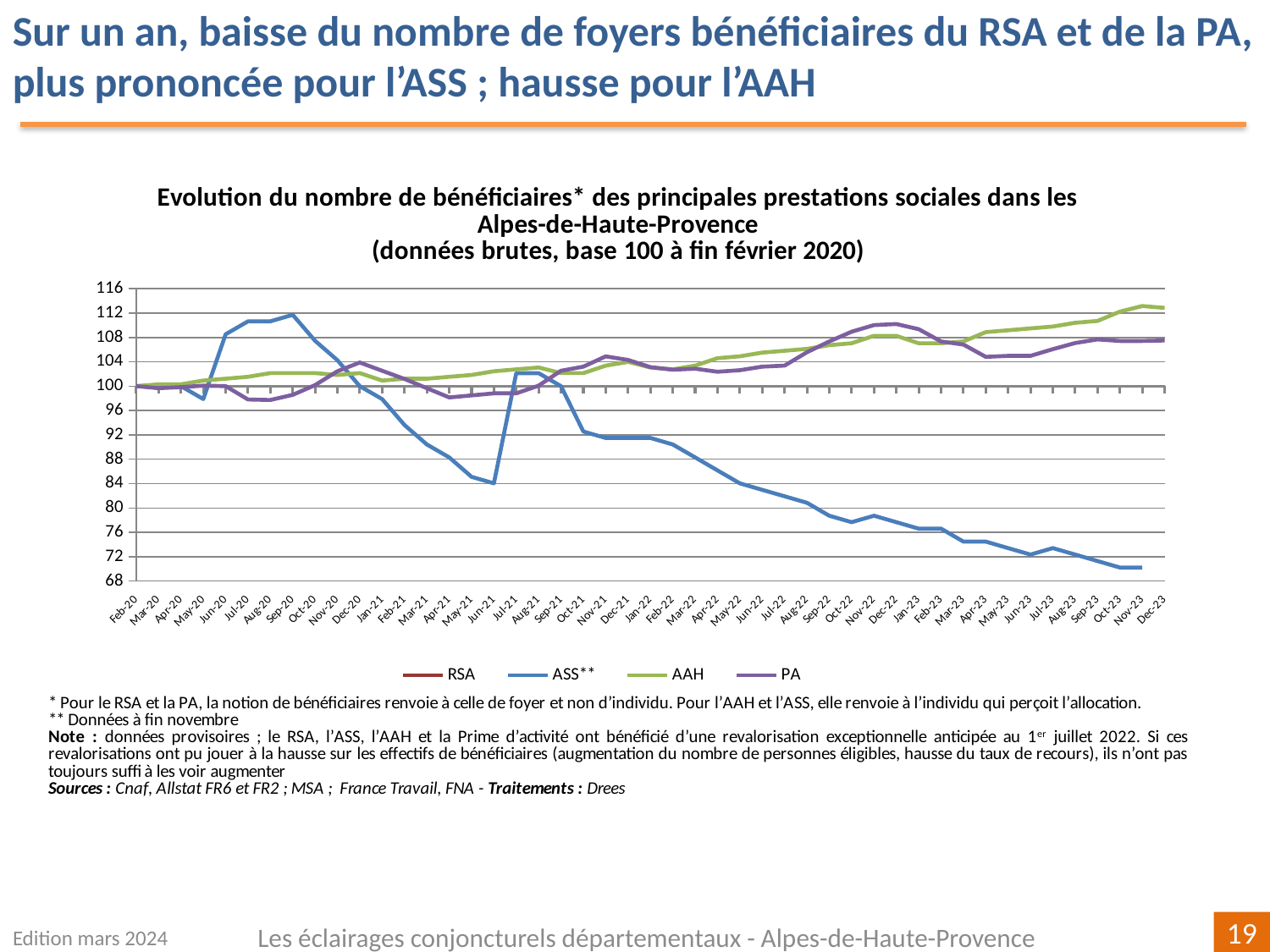
What is the value of the AAH series at Feb-20? 100 Is the value for ASS** at Aug-22 greater or less than 84? less What is the base period for the index of 100 according to the chart title? fin février 2020 Does the ASS** series generally rise or fall from Feb-20 to Dec-23? fall Is the value for AAH at Dec-23 greater or less than 108? greater At Dec-23, which is larger, the AAH value or the PA value? AAH How many series does the chart legend list? 4 What kind of chart is shown on the slide? line chart Which series has the highest value at Dec-23? AAH Is the value for PA at Aug-20 greater or less than 100? less